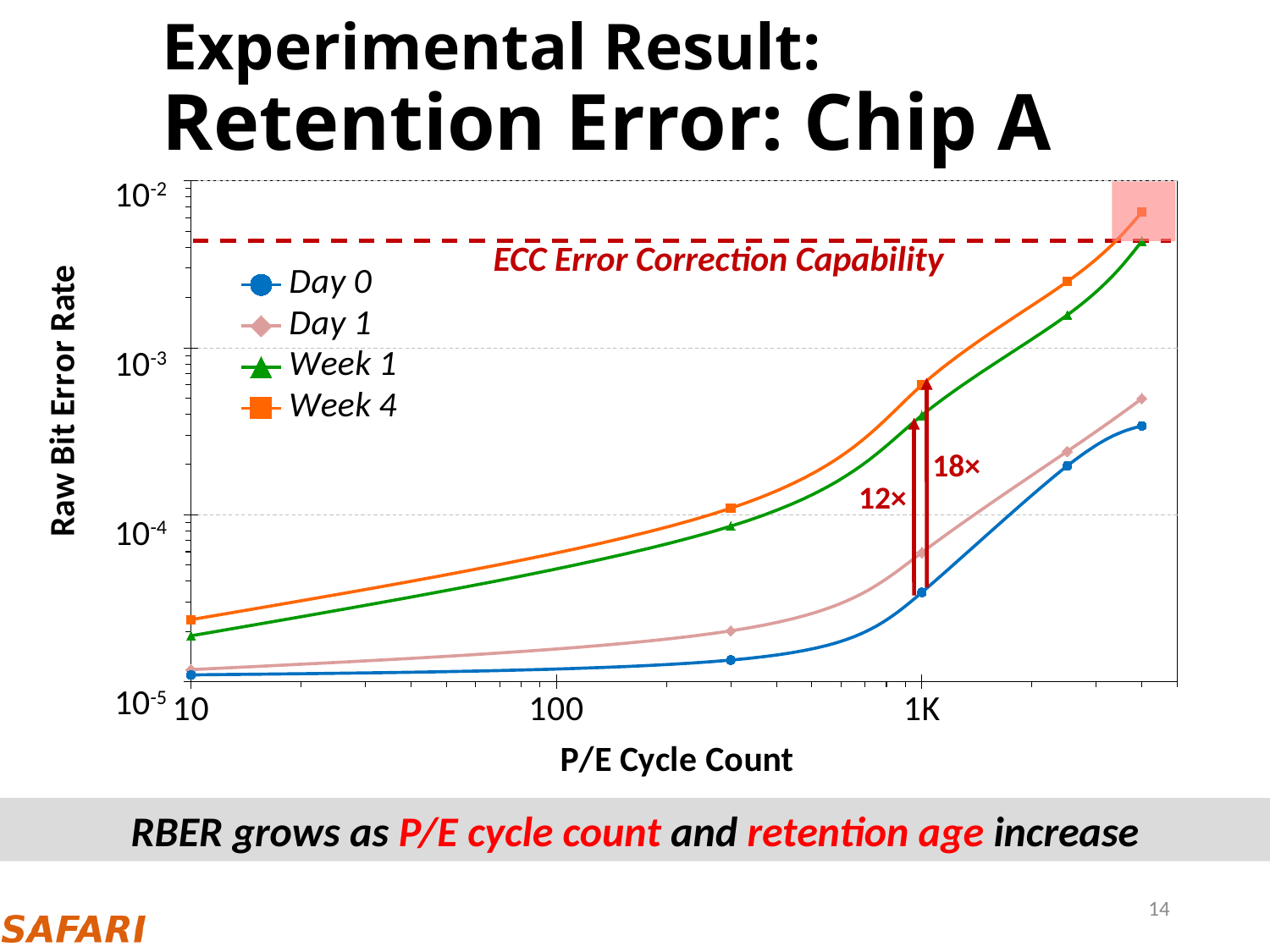
At a P/E Cycle Count of 10, is the Raw Bit Error Rate for Week 4 greater or less than 10^-4? less Which series has the highest Raw Bit Error Rate across the P/E cycle counts? Week 4 Does the Raw Bit Error Rate for Week 4 rise or fall as the P/E Cycle Count increases? rise What is the label of the x axis? P/E Cycle Count What kind of chart is shown on the slide? line chart How many data points are plotted for the Week 4 series? 5 At a P/E Cycle Count of 1K, is the Raw Bit Error Rate for Week 4 greater or less than 10^-4? greater At a P/E Cycle Count of 1K, is the Raw Bit Error Rate for Day 0 greater or less than 10^-4? less What are the series names listed in the legend? Day 0, Day 1, Week 1, Week 4 At a P/E Cycle Count of 1K, which series has the larger Raw Bit Error Rate, Week 1 or Day 1? Week 1 Which series has the lowest Raw Bit Error Rate across the P/E cycle counts? Day 0 How many series does the legend list? 4